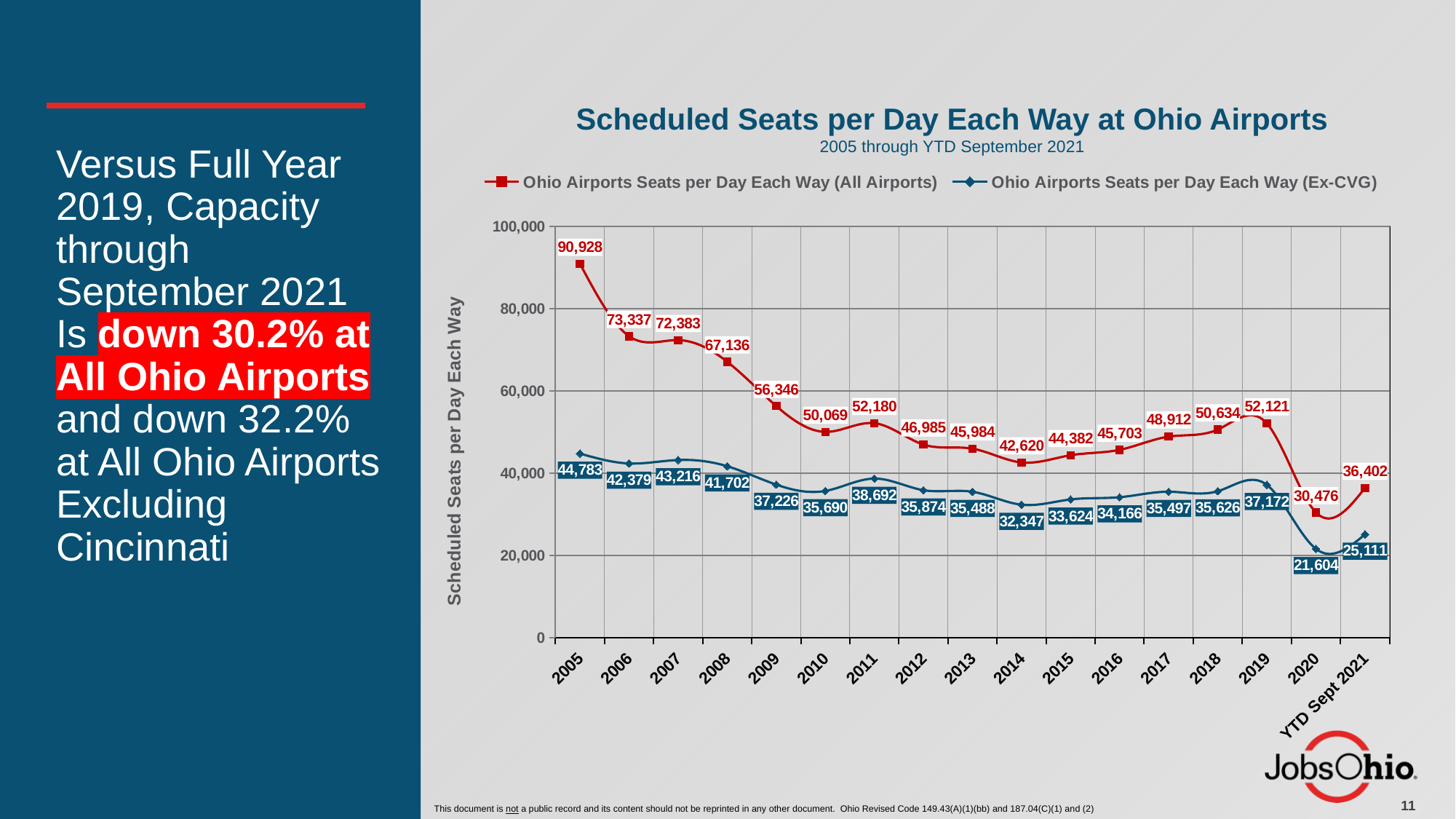
In 2019, how much higher is the All Airports value than the Ex-CVG value? 14,949 How many years (data points) are plotted along the x axis? 17 What is the value for Ohio Airports Seats per Day Each Way (All Airports) in 2005? 90,928 In which year is the All Airports series at its highest? 2005 What kind of chart is shown on the slide? Line chart What is the value for the All Airports series at YTD Sept 2021? 36,402 For the Ex-CVG series, which year has the larger value, 2011 or 2012? 2011 In which year is the Ex-CVG series at its lowest? 2020 In which year is the All Airports series at its lowest? 2020 How many series does the legend list? 2 What is the value for Ohio Airports Seats per Day Each Way (Ex-CVG) in 2020? 21,604 What is the difference between the All Airports values for 2019 and 2020? 21,645